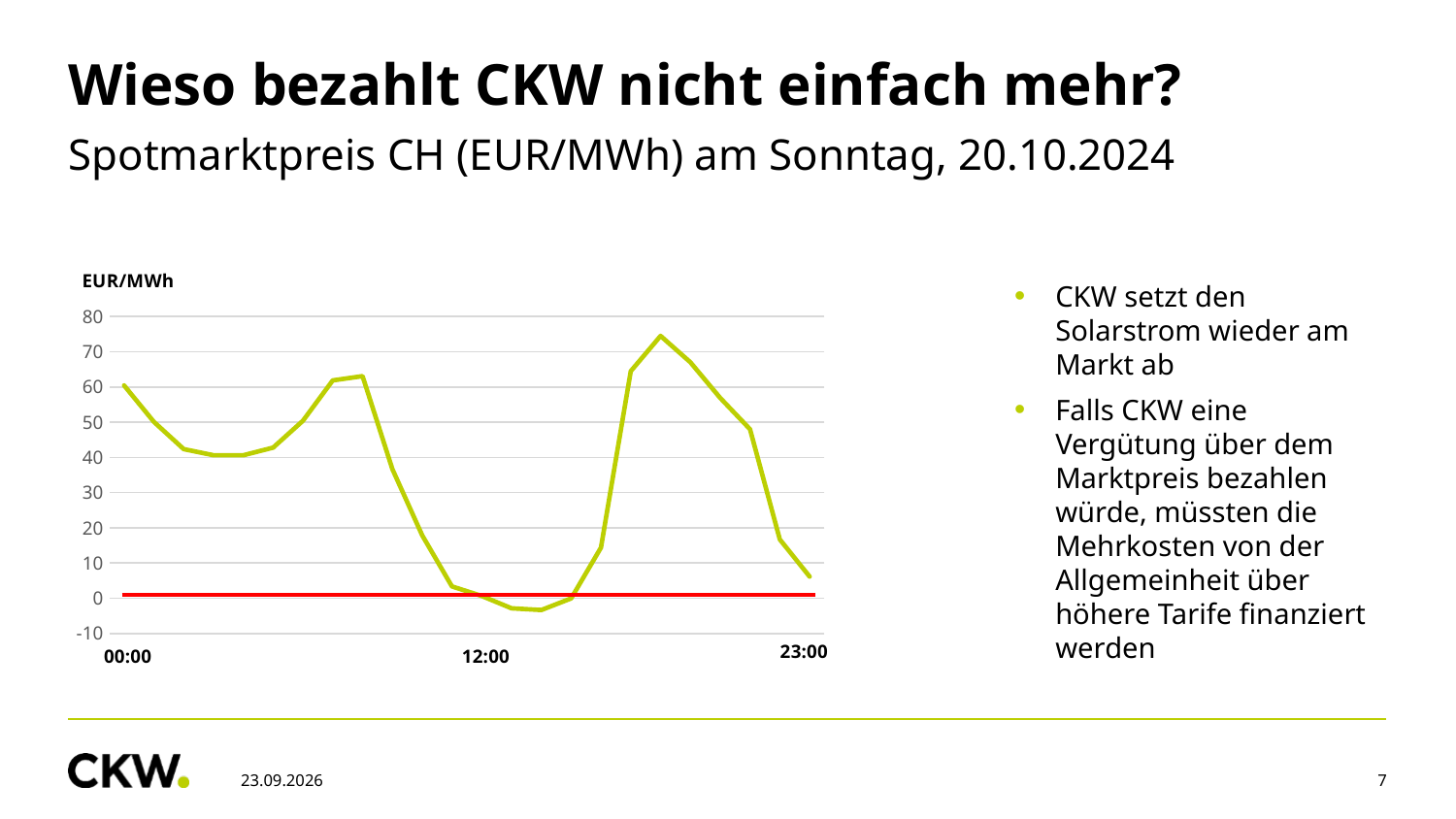
What kind of chart is shown on the slide? line chart Is the lowest value of the line greater or less than 0? less Is the value at 12:00 greater or less than 10? less Is the value at 23:00 greater or less than 20? less Does the line rise or fall from its afternoon peak to 23:00? fall Which is larger, the value at 00:00 or the value at 12:00? 00:00 What unit is shown on the vertical axis of the chart? EUR/MWh Which is larger, the value at 00:00 or the value at 23:00? 00:00 What is the title of the chart on the slide? Spotmarktpreis CH (EUR/MWh) am Sonntag, 20.10.2024 Does the line rise or fall between 12:00 and its afternoon peak? rise